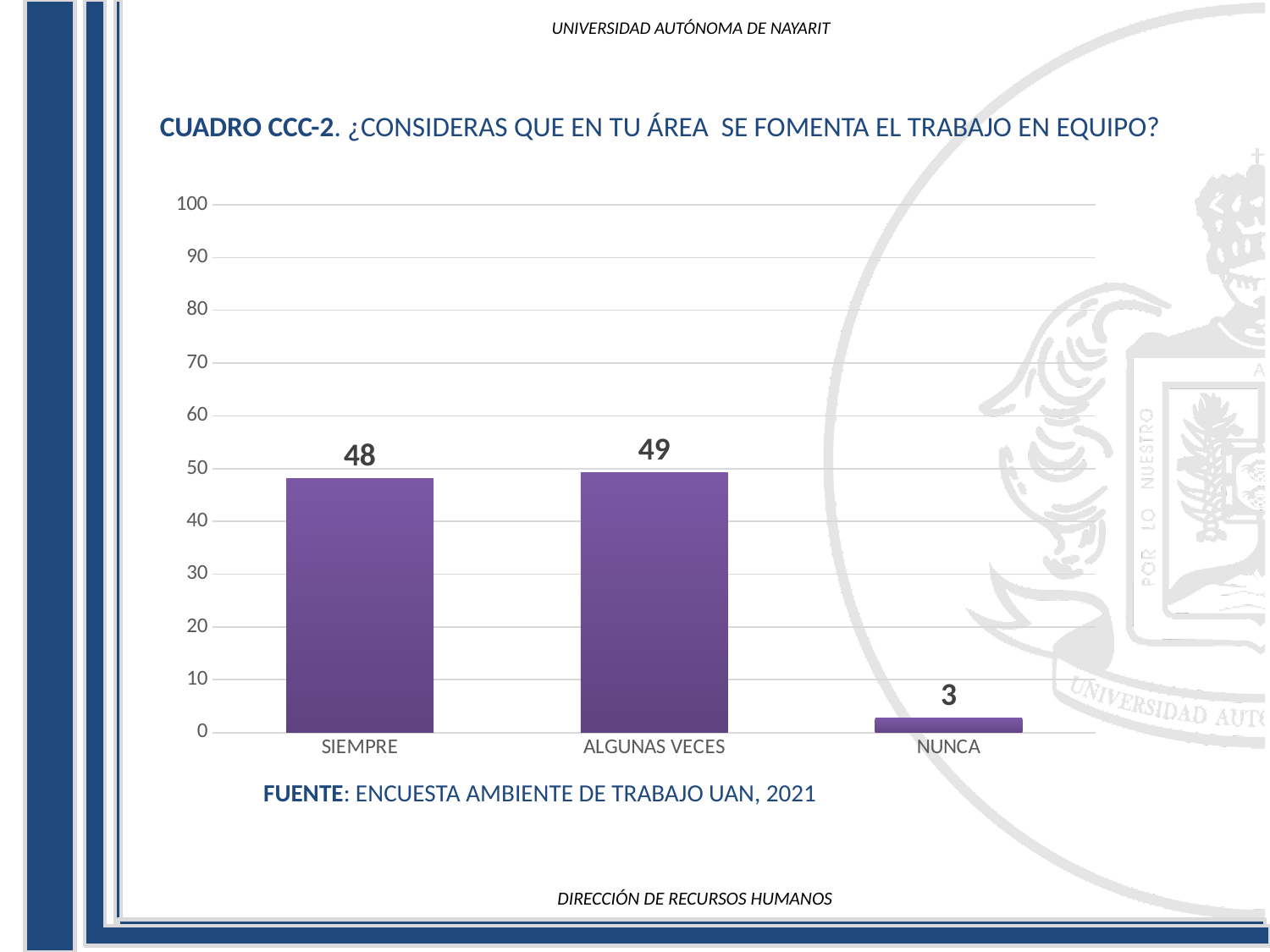
What is the difference between the values for SIEMPRE and NUNCA? 45 What kind of chart is shown on the slide? bar chart What is the value for SIEMPRE? 48 What is the value for ALGUNAS VECES? 49 Which category has the lowest value? NUNCA Which is larger, the value for SIEMPRE or the value for NUNCA? SIEMPRE What is the difference between the values for ALGUNAS VECES and SIEMPRE? 1 How many categories are shown on the x axis? 3 Is the value for ALGUNAS VECES greater or less than 60? less What is the value for NUNCA? 3 Is the value for NUNCA greater or less than 10? less What source is cited below the chart? ENCUESTA AMBIENTE DE TRABAJO UAN, 2021